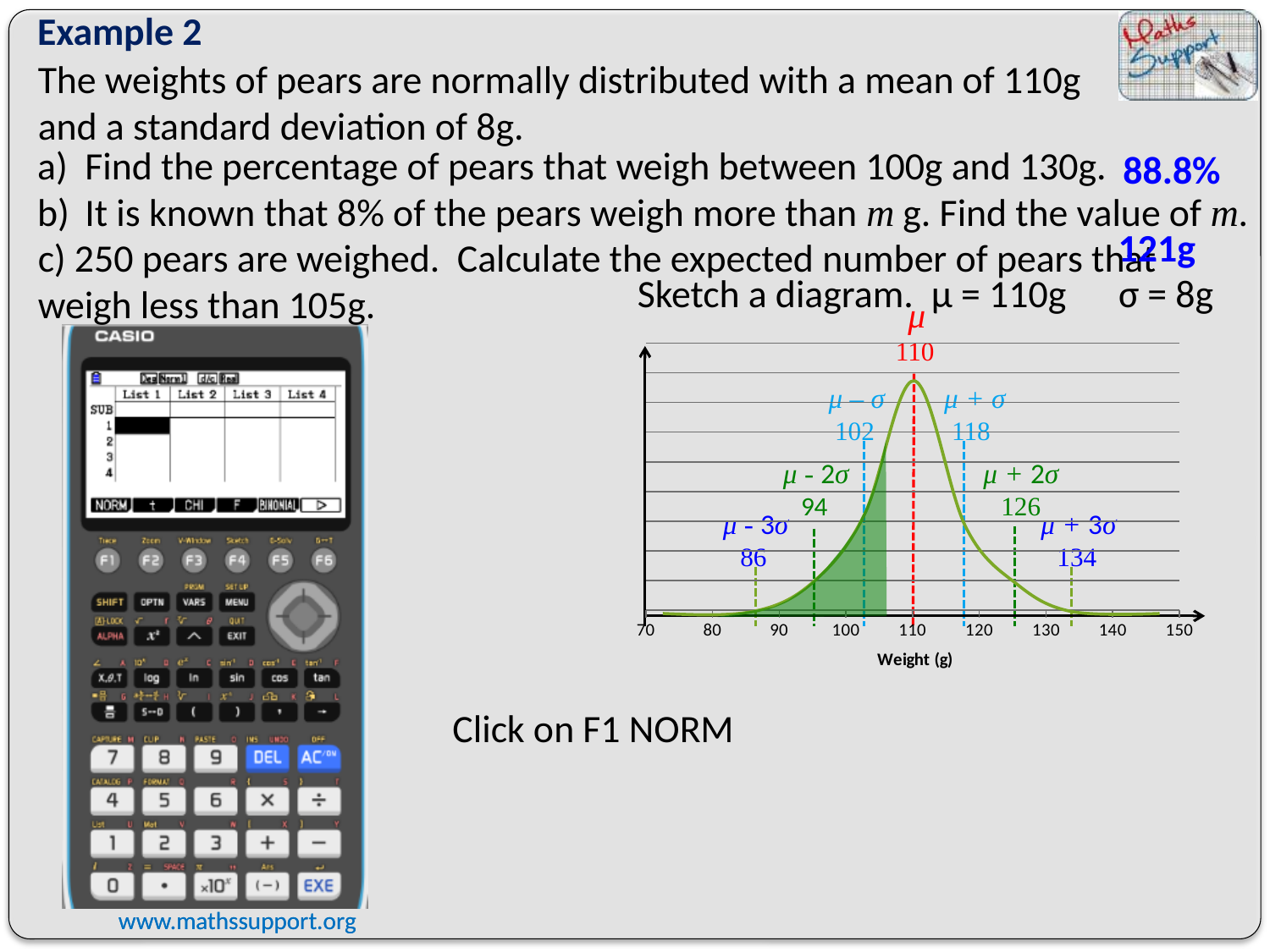
What value is marked at μ – σ on the normal distribution chart? 102 What is the x-axis label of the normal distribution chart? Weight (g) What is the lowest value shown on the x-axis of the normal distribution chart? 70 Is the value marked at μ + 2σ on the normal distribution chart greater or less than 120? greater What is the difference between the values marked at μ + σ and μ – σ on the normal distribution chart? 16 What value is marked at μ + 3σ on the normal distribution chart? 134 What is the highest value shown on the x-axis of the normal distribution chart? 150 What value is marked at μ - 2σ on the normal distribution chart? 94 What value is marked at μ - 3σ on the normal distribution chart? 86 What value is marked at μ + 2σ on the normal distribution chart? 126 What value is marked at μ + σ on the normal distribution chart? 118 What value is marked at the mean (μ) on the normal distribution chart? 110